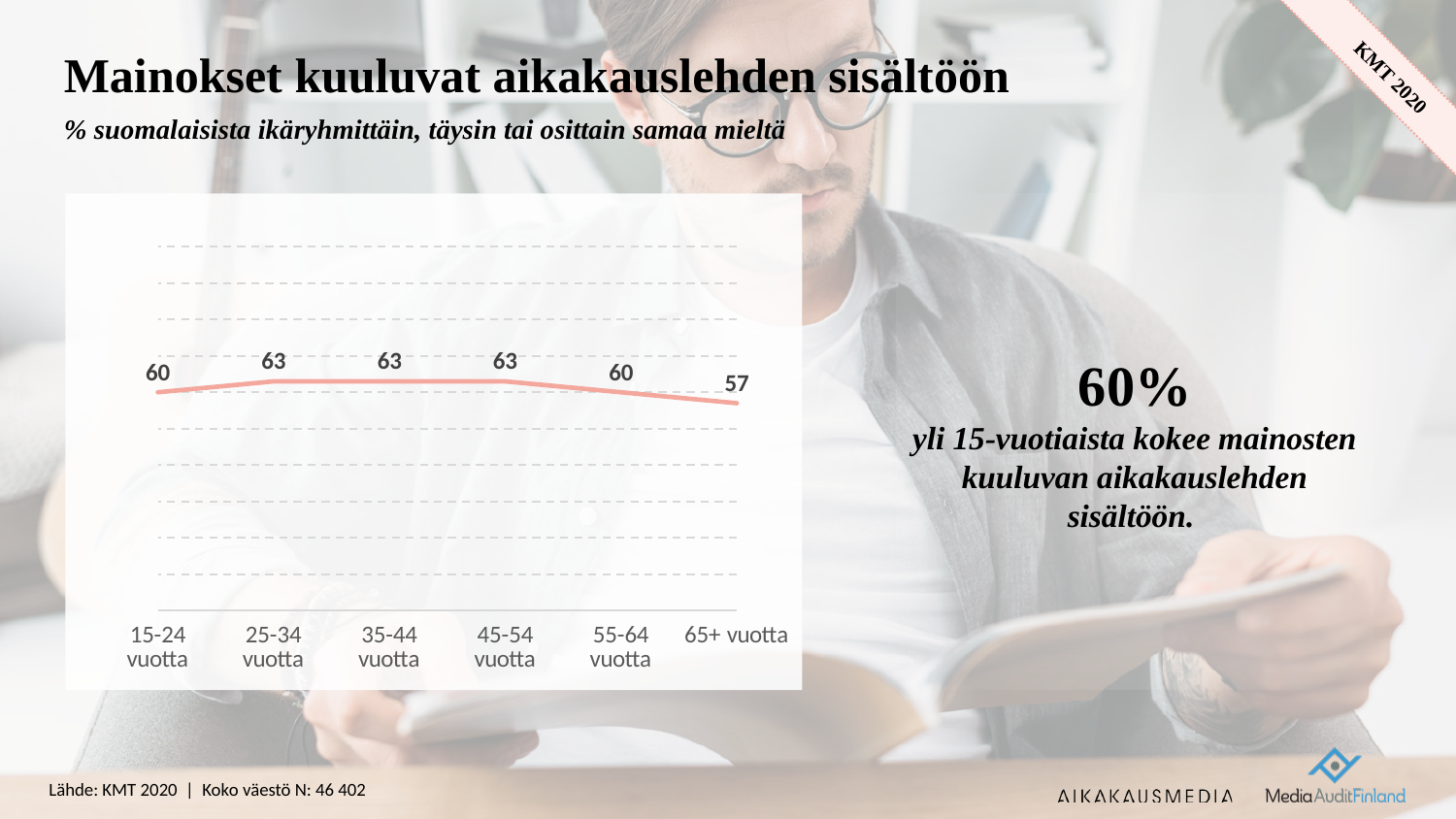
What is the value for the 35-44 vuotta age group? 63 What is the value for the 55-64 vuotta age group? 60 What is the difference between the values for 45-54 vuotta and 55-64 vuotta? 3 What is the value for the 15-24 vuotta age group? 60 What is the value for the 65+ vuotta age group? 57 Do the values rise or fall from 45-54 vuotta to 65+ vuotta? Fall Which age group has the lowest value? 65+ vuotta What is the title of the slide containing the chart? Mainokset kuuluvat aikakauslehden sisältöön What is the difference between the values for 25-34 vuotta and 65+ vuotta? 6 How many age groups are plotted on the chart? 6 What kind of chart is shown on the slide? Line chart Which is larger, the value for 45-54 vuotta or the value for 65+ vuotta? 45-54 vuotta